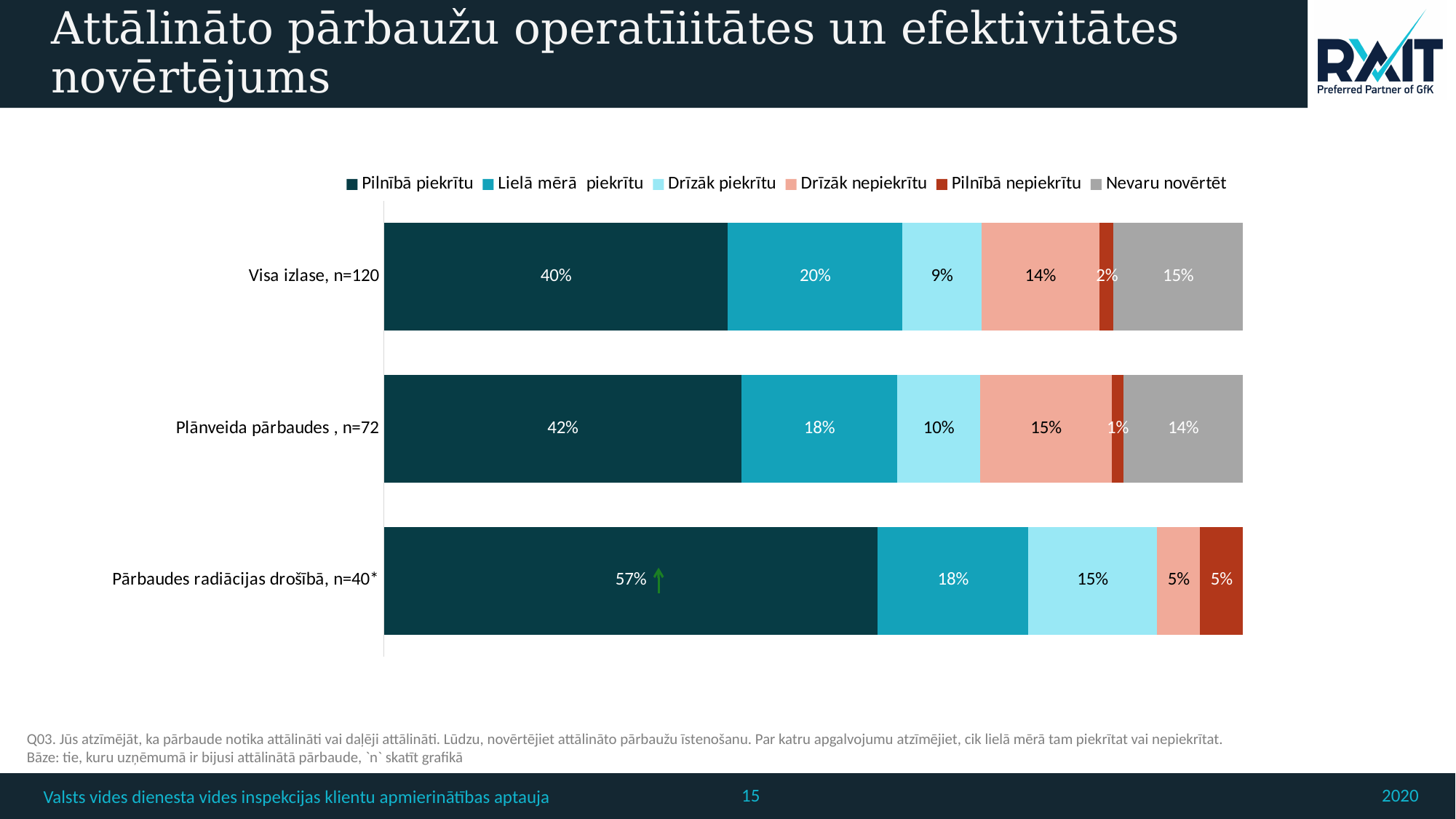
What is the total of the stacked bar for "Plānveida pārbaudes , n=72"? 100% How many series does the legend list? 6 What is the difference between the "Pilnībā piekrītu" values for "Pārbaudes radiācijas drošībā, n=40*" and "Visa izlase, n=120"? 17 percentage points What is the value of "Drīzāk piekrītu" for "Plānveida pārbaudes , n=72"? 10% Which is larger: "Drīzāk nepiekrītu" for "Visa izlase, n=120" or for "Plānveida pārbaudes , n=72"? Plānveida pārbaudes , n=72 What is the value of "Pilnībā piekrītu" for "Visa izlase, n=120"? 40% What kind of chart is shown on the slide? Stacked bar chart Which category has the highest "Pilnībā piekrītu" value? Pārbaudes radiācijas drošībā, n=40* How many categories (bars) are plotted in the chart? 3 Which category has the lowest "Drīzāk nepiekrītu" value? Pārbaudes radiācijas drošībā, n=40* What is the value of "Pilnībā piekrītu" for "Pārbaudes radiācijas drošībā, n=40*"? 57% What is the value of "Nevaru novērtēt" for "Visa izlase, n=120"? 15%